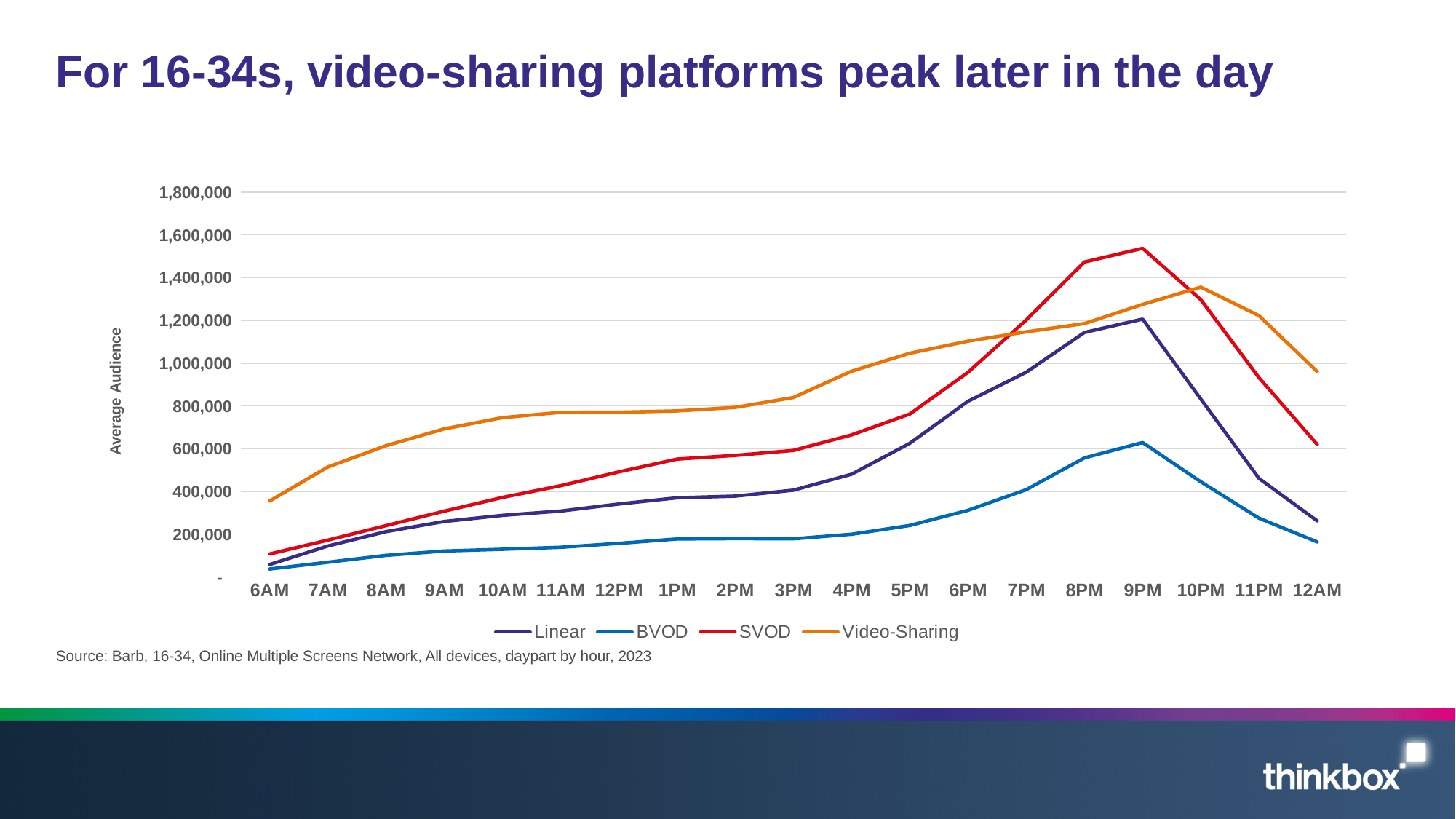
Is the value for BVOD at 9PM greater or less than 800,000? less At which hour does the Linear line reach its highest value? 9PM What kind of chart is shown on the slide? line chart At 6AM, which series has the higher value, Video-Sharing or SVOD? Video-Sharing Is the value for SVOD at 9PM greater or less than 1,400,000? greater How many hourly time points are plotted along the x axis? 19 How many series does the legend list? 4 Is the value for Video-Sharing at 6AM greater or less than 200,000? greater Which series has the lowest value at 12AM? BVOD At which hour does the SVOD line reach its highest value? 9PM What is the title of the vertical axis? Average Audience At which hour does the Video-Sharing line reach its highest value? 10PM